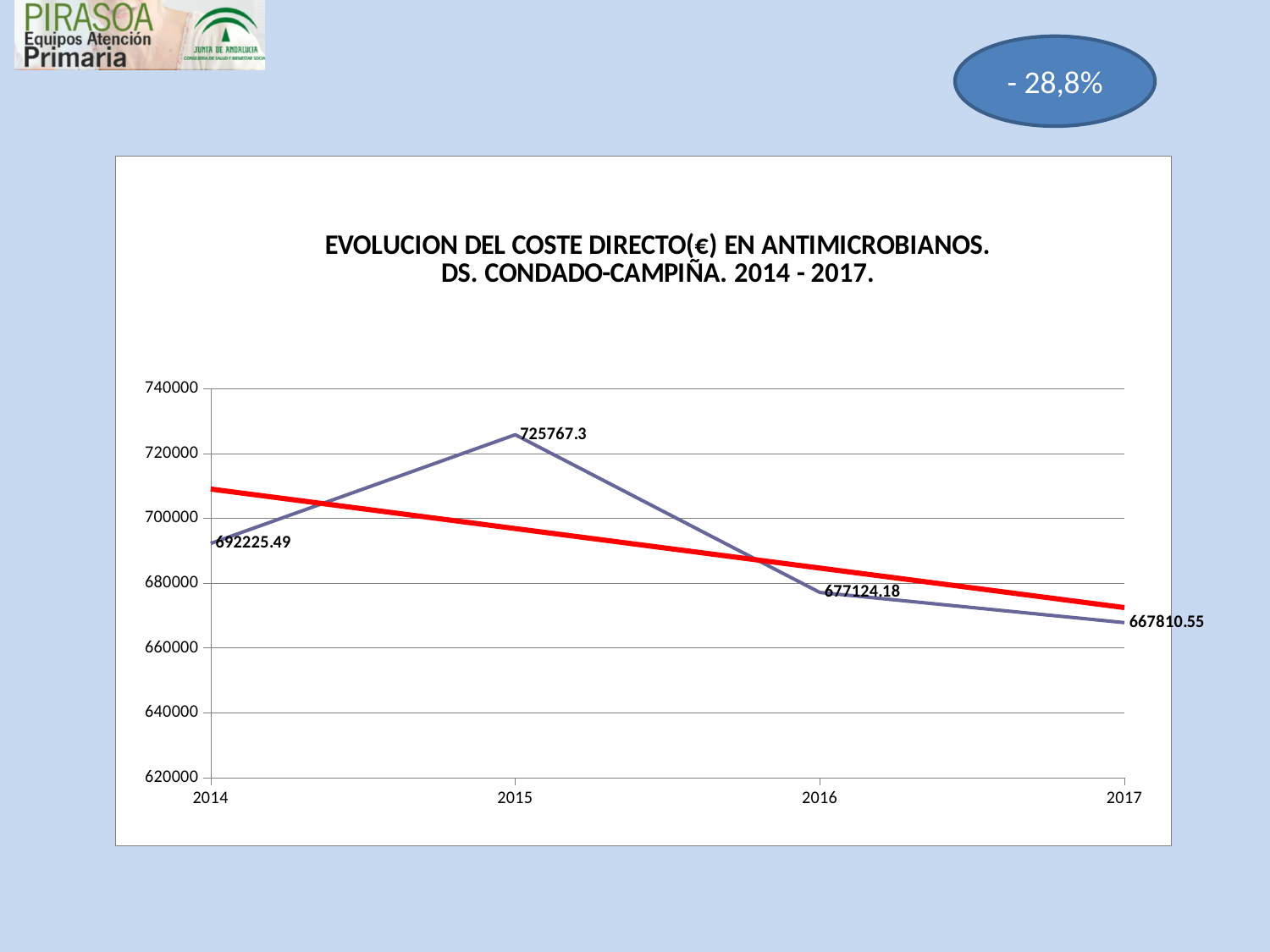
What kind of chart is shown on the slide? Line chart What is the direct cost value plotted for 2015? 725767.3 Which year has the highest direct cost in antimicrobials? 2015 What is the direct cost value plotted for 2016? 677124.18 Is the value for 2015 greater or less than 720000? greater What is the direct cost value plotted for 2017? 667810.55 How many years are plotted on the x axis? 4 By how much did the direct cost fall from 2015 to 2016? 48643.12 Which is larger, the value for 2014 or the value for 2016? 2014 What is the direct cost value plotted for 2014? 692225.49 What is the difference between the 2014 value and the 2017 value? 24414.94 Which year has the lowest direct cost in antimicrobials? 2017